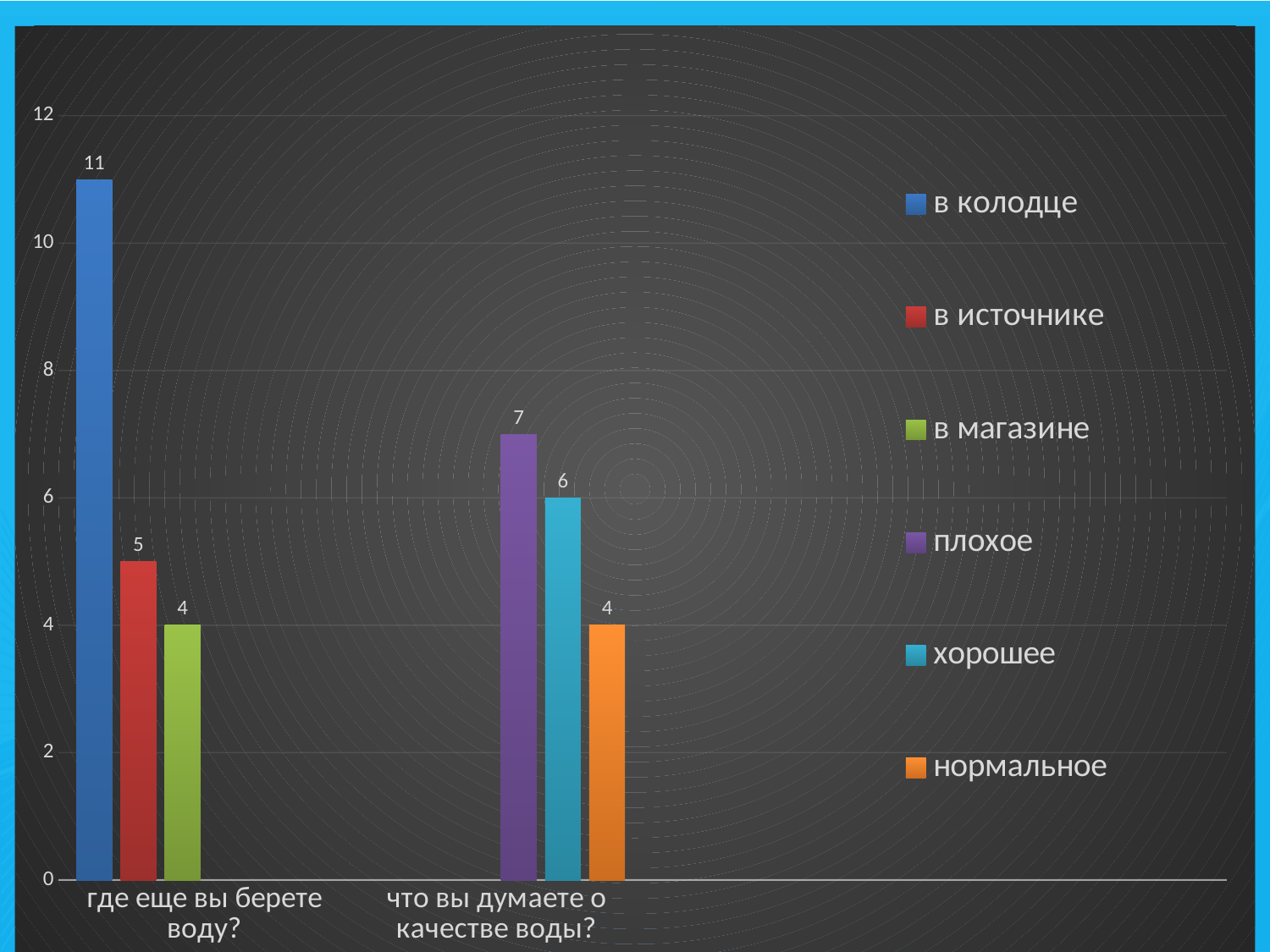
Which series has the highest value on the chart? в колодце How many series does the legend list? 6 What is the value for "плохое" in the "что вы думаете о качестве воды?" category? 7 Which series has the highest value in the "что вы думаете о качестве воды?" category? плохое What is the value for "хорошее"? 6 What is the value for "в магазине"? 4 What is the value for "в источнике"? 5 What kind of chart is shown on the slide? bar chart What is the difference between the values for "в колодце" and "в источнике"? 6 What is the value for "в колодце" in the "где еще вы берете воду?" category? 11 Which is larger, the value for "плохое" or the value for "хорошее"? плохое What is the value for "нормальное"? 4